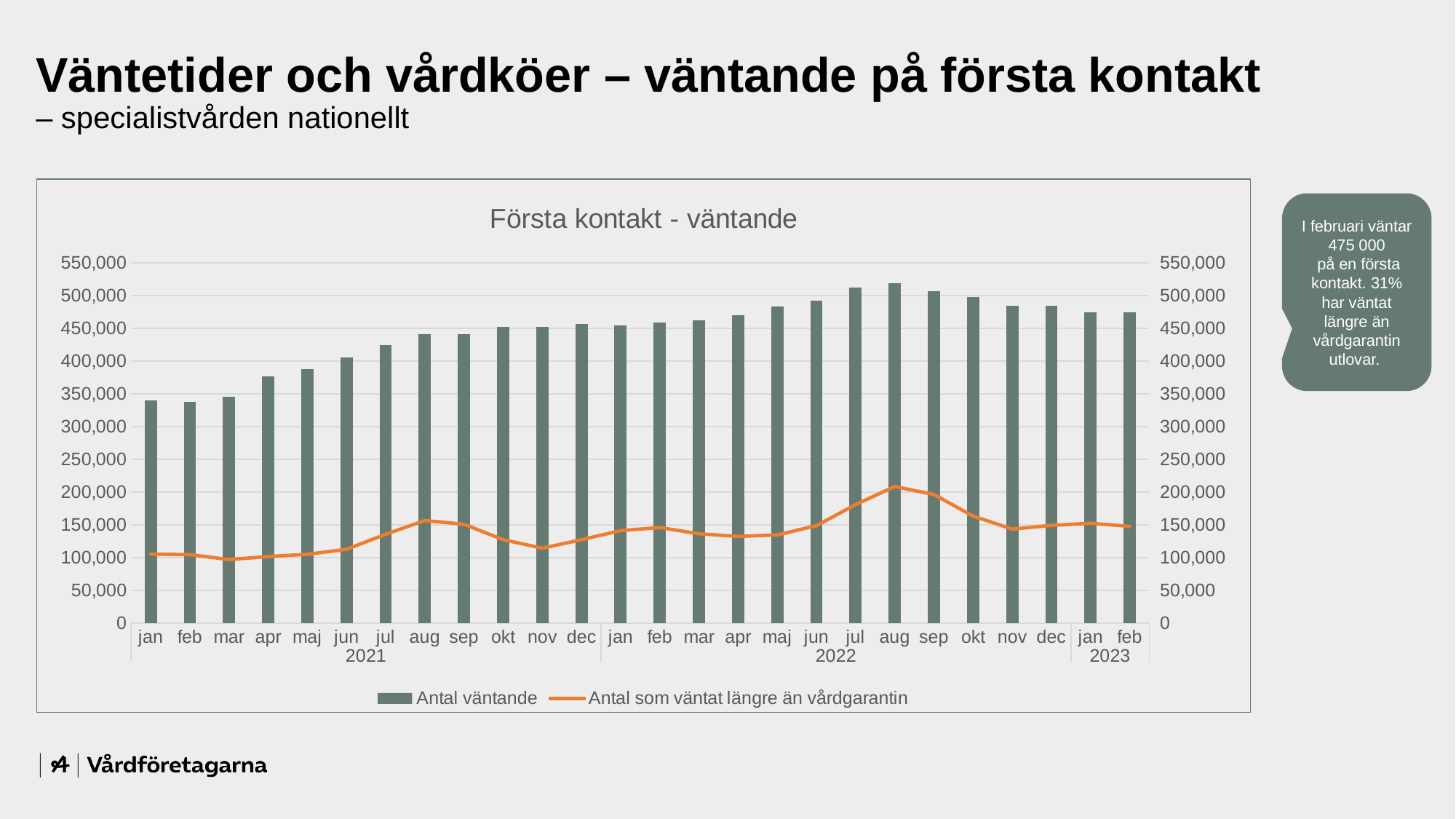
How many series does the legend list? 2 How many months are plotted along the x axis? 26 Is the Antal väntande bar for aug 2022 greater or less than 500,000? greater Is the Antal väntande bar for apr 2021 greater or less than 350,000? greater Which is larger, the Antal väntande bar for jan 2021 or for jan 2022? jan 2022 What kind of chart is shown on the slide? A combined bar and line chart Do the Antal väntande bars generally rise or fall from jan 2021 to aug 2022? rise Is the Antal väntande bar for jan 2021 greater or less than 350,000? less Which is larger, the Antal som väntat längre än vårdgarantin value for aug 2021 or for aug 2022? aug 2022 In which month is the bar for Antal väntande highest? aug 2022 What is the title of the chart? Första kontakt - väntande